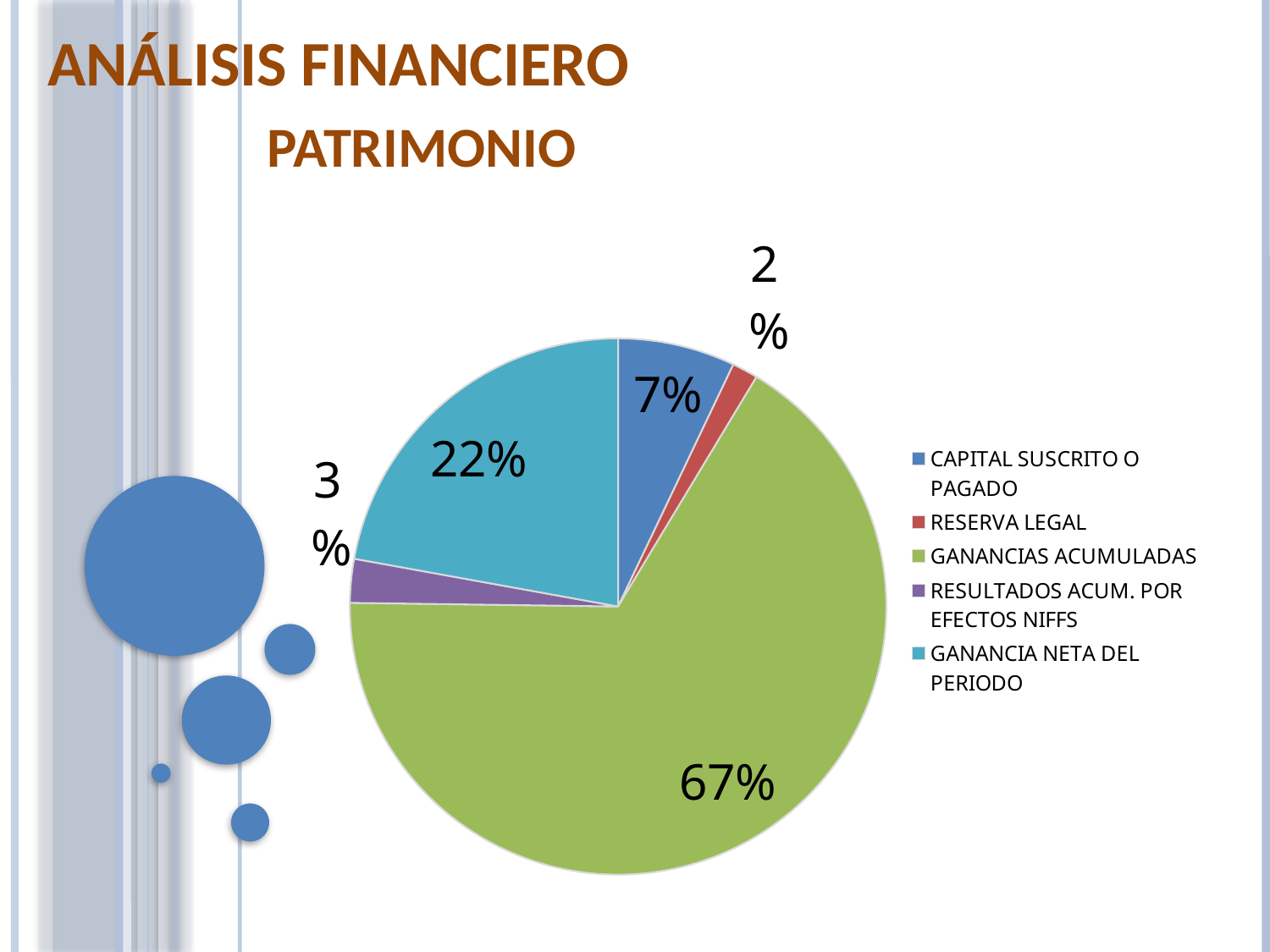
Which category has the largest slice of the pie? GANANCIAS ACUMULADAS What colour is the slice for GANANCIA NETA DEL PERIODO? Teal (light blue) What is the difference between the shares of GANANCIAS ACUMULADAS and GANANCIA NETA DEL PERIODO? 45% Which is larger, the share for CAPITAL SUSCRITO O PAGADO or the share for RESULTADOS ACUM. POR EFECTOS NIFFS? CAPITAL SUSCRITO O PAGADO How many categories does the legend list? 5 What is the value shown for RESERVA LEGAL? 2% What share of the pie does GANANCIAS ACUMULADAS represent? 67% What is the value shown for CAPITAL SUSCRITO O PAGADO? 7% What kind of chart is shown on the slide? Pie chart What share of the pie does GANANCIA NETA DEL PERIODO represent? 22% Which category has the smallest slice of the pie? RESERVA LEGAL What is the value shown for RESULTADOS ACUM. POR EFECTOS NIFFS? 3%